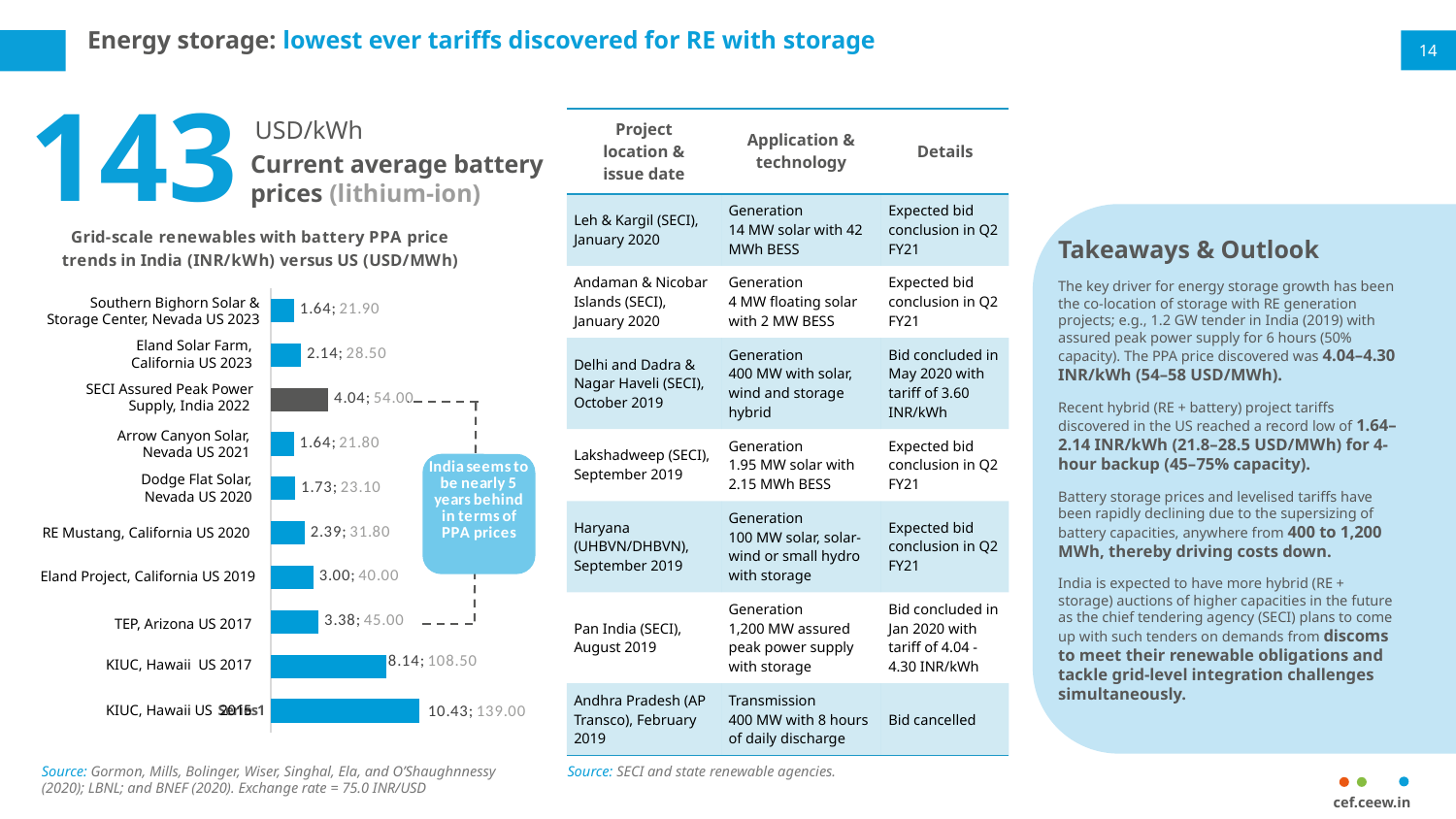
What is the PPA price in USD/MWh for KIUC, Hawaii US 2017? 108.50 What kind of chart is shown on the slide? Bar chart What is the PPA price in INR/kWh for the SECI Assured Peak Power Supply, India 2022? 4.04 What is the difference in USD/MWh between Dodge Flat Solar, Nevada US 2020 and Southern Bighorn Solar & Storage Center, Nevada US 2023? 1.20 Which project has the highest PPA price in the chart? KIUC, Hawaii US 2015 What is the PPA price in INR/kWh for Eland Solar Farm, California US 2023? 2.14 How many projects are plotted in the chart? 10 What is the difference in INR/kWh between KIUC, Hawaii US 2015 and KIUC, Hawaii US 2017? 2.29 Which project has the lowest PPA price in USD/MWh in the chart? Arrow Canyon Solar, Nevada US 2021 What is the title of the chart? Grid-scale renewables with battery PPA price trends in India (INR/kWh) versus US (USD/MWh) Which has a higher PPA price: RE Mustang, California US 2020 or Eland Project, California US 2019? Eland Project, California US 2019 What is the PPA price in USD/MWh for TEP, Arizona US 2017? 45.00